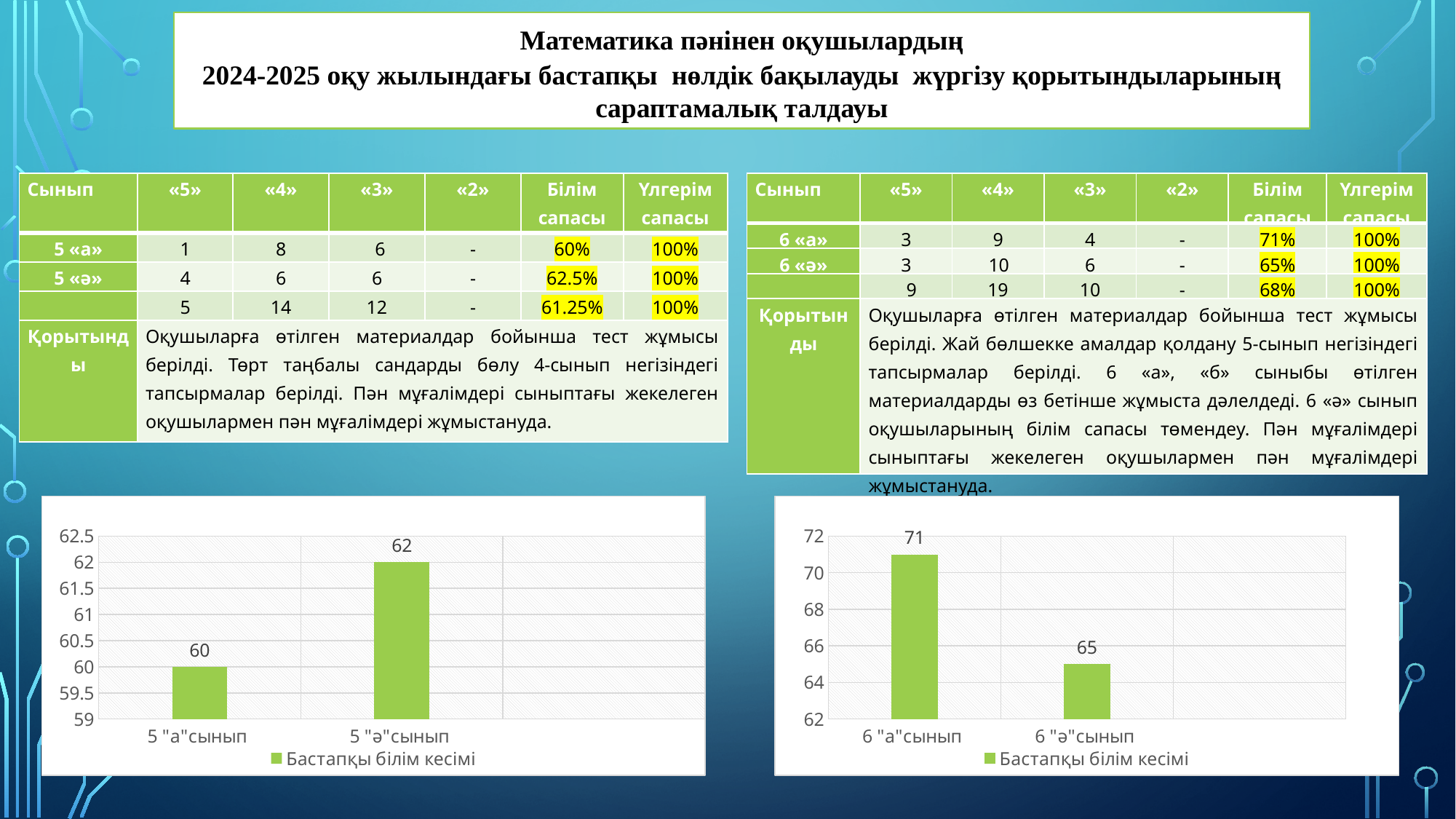
In the left chart, what is the value for 5 "ә"сынып? 62 In the right chart, what is the value for 6 "ә"сынып? 65 In the left chart, which category has the highest value? 5 "ә"сынып In the left chart, what is the value for 5 "а"сынып? 60 In the right chart, which is larger: the value for 6 "а"сынып or 6 "ә"сынып? 6 "а"сынып What kind of chart is the right chart? bar chart What series name does the legend of the left chart show? Бастапқы білім кесімі In the right chart, what is the value for 6 "а"сынып? 71 In the left chart, what is the difference between the values for 5 "ә"сынып and 5 "а"сынып? 2 In the right chart, what is the difference between the values for 6 "а"сынып and 6 "ә"сынып? 6 In the right chart, which category has the lowest value? 6 "ә"сынып How many categories are shown in the left chart? 2